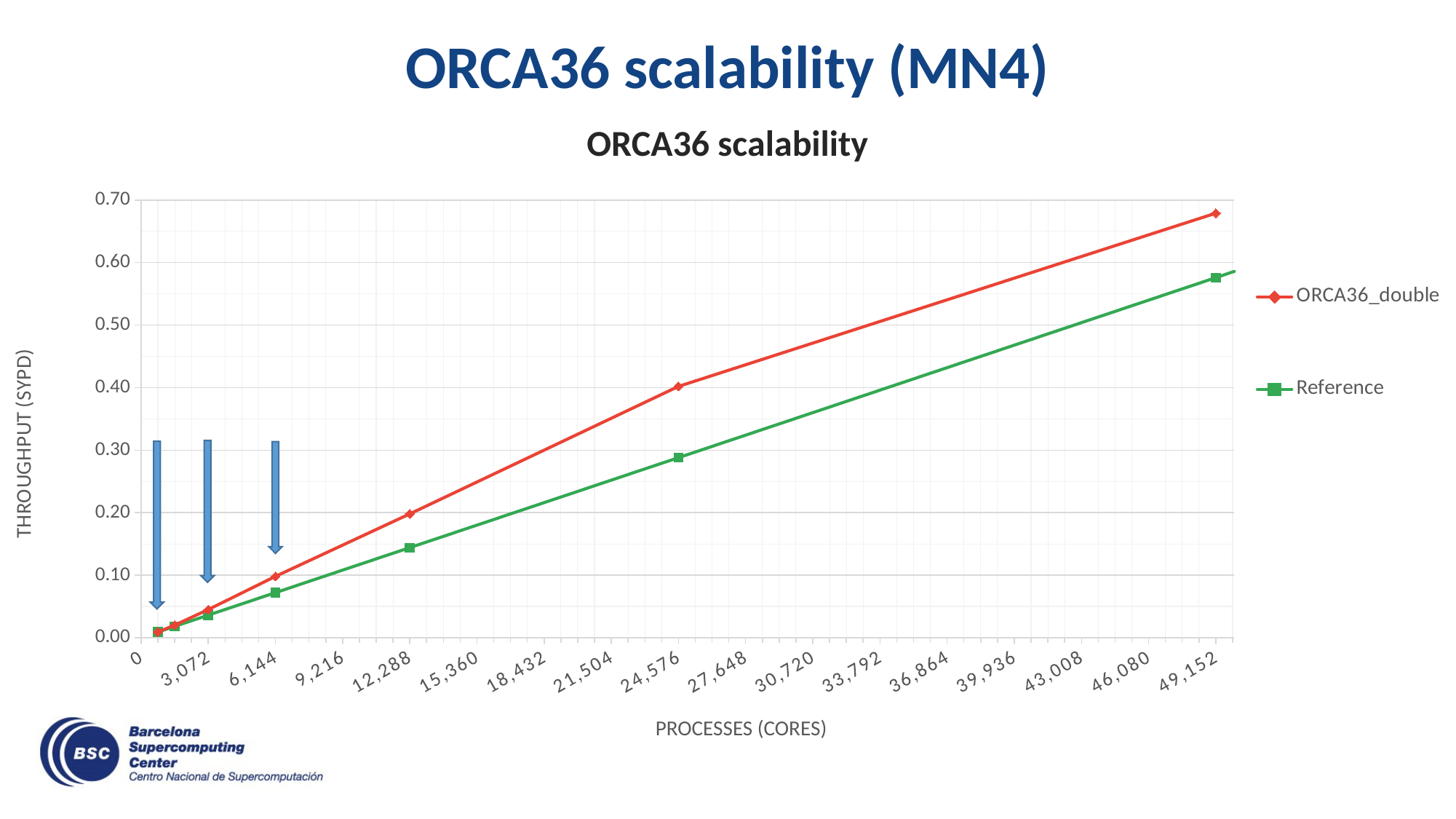
What is the label of the y axis? THROUGHPUT (SYPD) Is the throughput of ORCA36_double at 49,152 processes greater or less than 0.60? greater Which series has the higher throughput at 24,576 processes? ORCA36_double Does the throughput of the ORCA36_double series rise or fall as the number of processes increases? Rises Is the throughput of Reference at 12,288 processes greater or less than 0.20? less Which series has the higher throughput at 49,152 processes? ORCA36_double What colour is the Reference series line? Green Is the throughput of Reference at 49,152 processes greater or less than 0.60? less How many series does the legend list? 2 What kind of chart is shown on the slide? Line chart